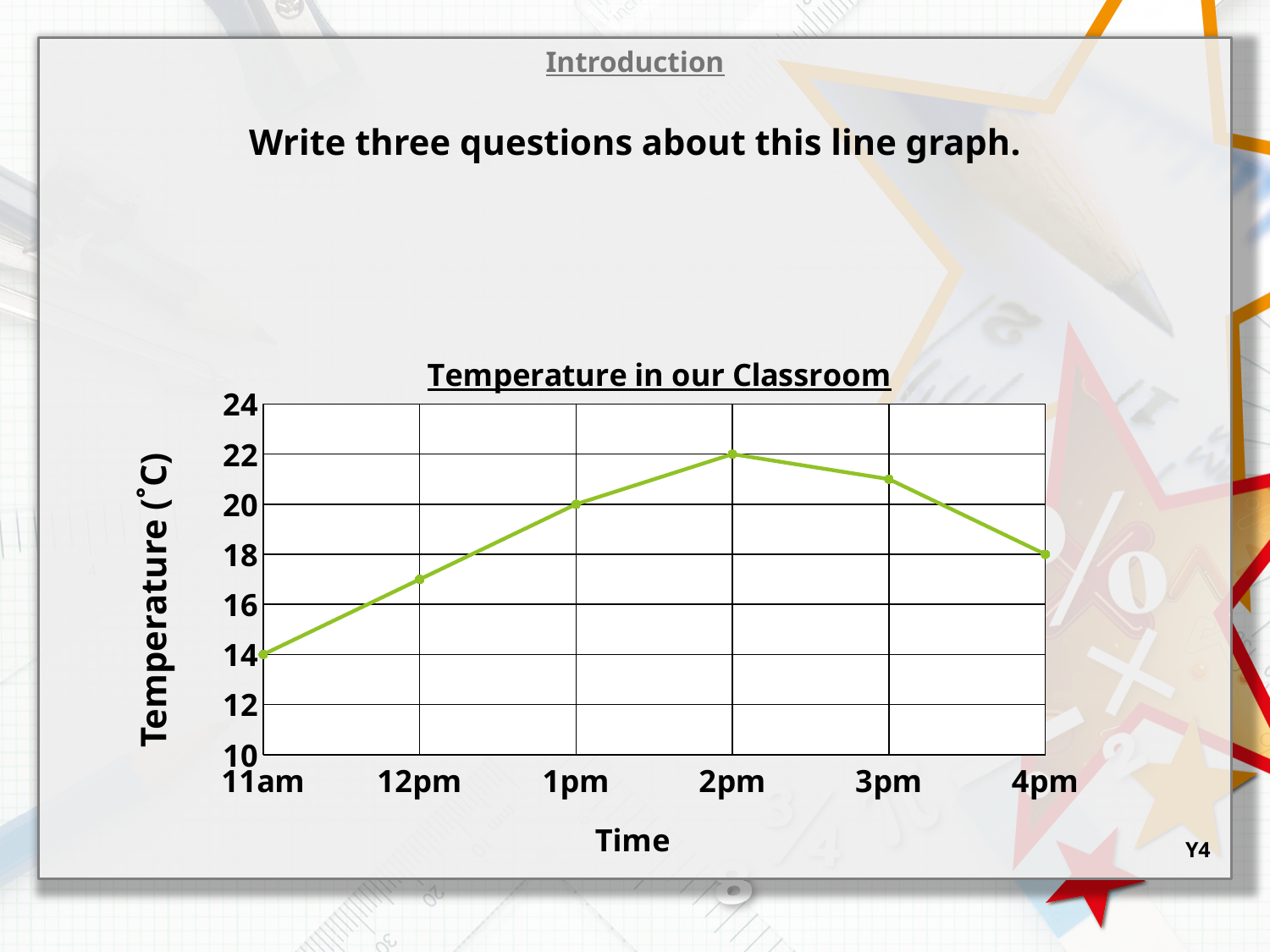
At what time is the temperature highest? 2pm What is the title of the chart? Temperature in our Classroom What is the temperature at 2pm? 22 Is the temperature at 3pm greater or less than 20? greater What is the temperature at 4pm? 18 How many time points are plotted on the graph? 6 Is the temperature at 12pm greater or less than 16? greater What is the temperature at 11am? 14 What is the difference between the temperature at 2pm and at 11am? 8 What kind of chart is shown on the slide? line chart Which is higher, the temperature at 1pm or at 4pm? 1pm At what time is the temperature lowest? 11am